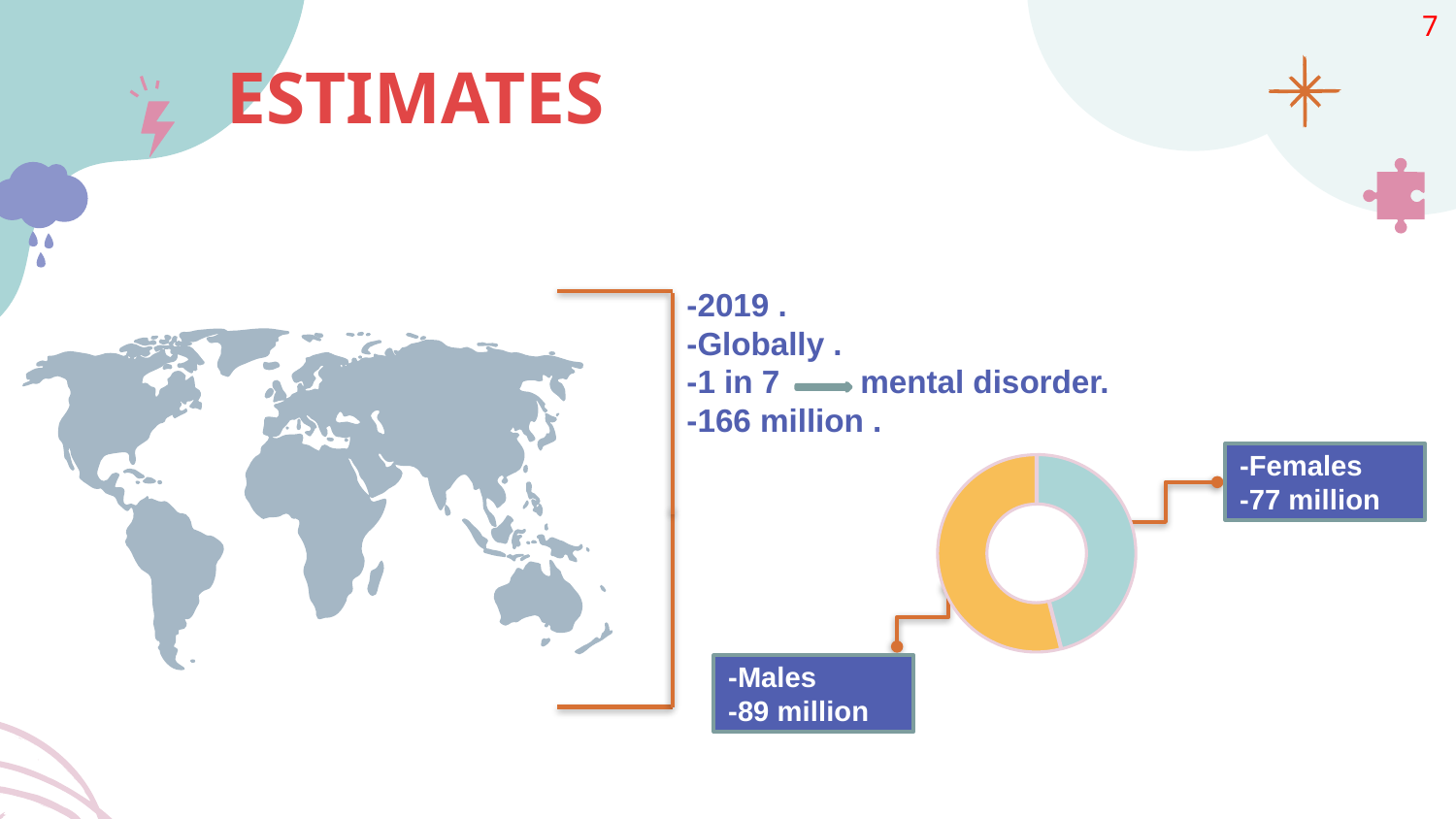
Which group has the larger slice in the doughnut chart, Males or Females? Males What colour is the Males slice in the doughnut chart? orange Which group has the smallest slice in the doughnut chart? Females What is the combined total of the Males and Females slices in the doughnut chart? 166 million How many slices does the doughnut chart have? 2 Which group has the largest slice in the doughnut chart? Males What share of the doughnut chart total do Males represent? 53.6% What is the value for Males in the doughnut chart? 89 million What colour is the Females slice in the doughnut chart? light teal What is the value for Females in the doughnut chart? 77 million What is the difference between the Males and Females values in the doughnut chart? 12 million What kind of chart is shown on the slide? doughnut chart